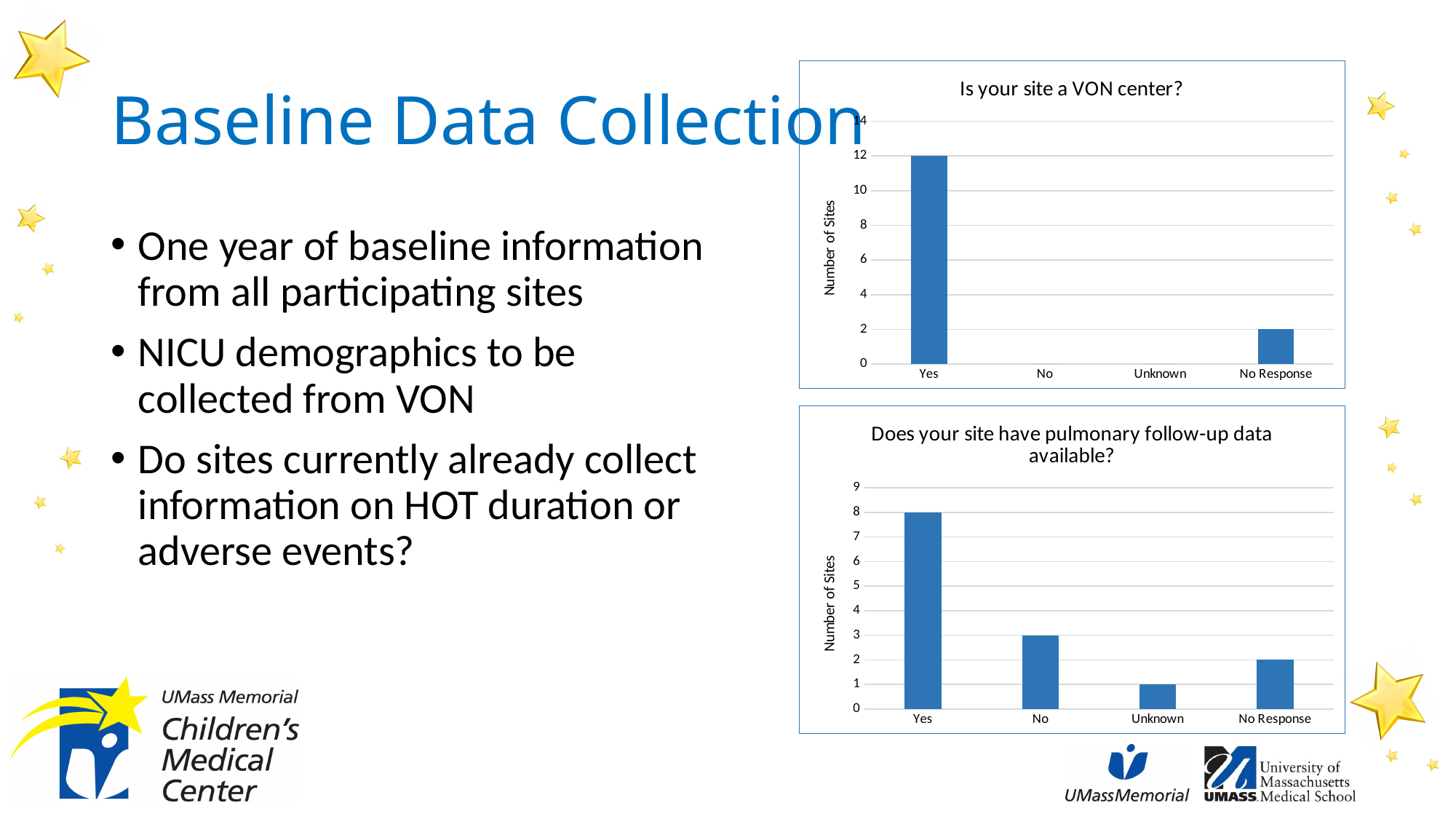
In the chart titled "Does your site have pulmonary follow-up data available?", how many sites answered No? 3 In the chart titled "Is your site a VON center?", how many sites gave No Response? 2 In the chart titled "Does your site have pulmonary follow-up data available?", which category has the lowest number of sites? Unknown In the chart titled "Does your site have pulmonary follow-up data available?", which is larger, the value for No or the value for No Response? No In the chart titled "Does your site have pulmonary follow-up data available?", how many sites answered Unknown? 1 In the chart titled "Is your site a VON center?", what is the difference between the Yes and No Response values? 10 In the chart titled "Is your site a VON center?", which category has the highest number of sites? Yes What type of chart is the bottom chart on the slide? Bar chart In the chart titled "Is your site a VON center?", how many sites answered Yes? 12 In the chart titled "Does your site have pulmonary follow-up data available?", what is the difference between the Yes and No values? 5 In the chart titled "Is your site a VON center?", how many categories are shown on the x axis? 4 In the chart titled "Does your site have pulmonary follow-up data available?", how many sites answered Yes? 8